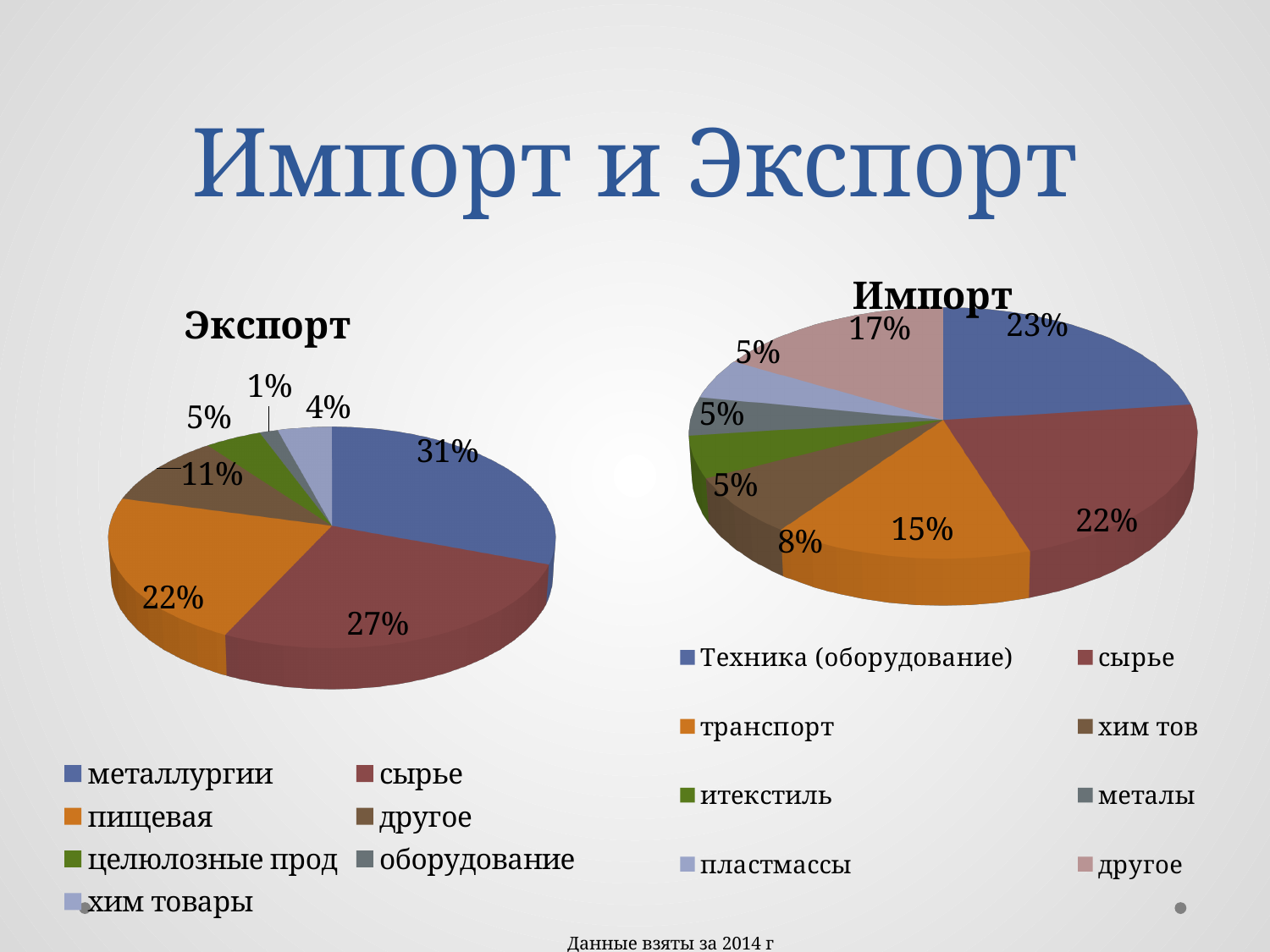
In the Экспорт chart, what share does металлургии have? 31% In the Экспорт chart, what share does пищевая have? 22% How many categories does the legend of the Импорт chart list? 8 In the Импорт chart, what share does другое have? 17% In the Экспорт chart, which category has the largest share? металлургии What type of chart is the Импорт chart? pie chart In the Импорт chart, which is larger: транспорт or хим тов? транспорт How many categories does the legend of the Экспорт chart list? 7 In the Импорт chart, what share does Техника (оборудование) have? 23% In the Экспорт chart, what is the difference between the shares of металлургии and сырье? 4% In the Экспорт chart, which category has the smallest share? оборудование In the Импорт chart, which category has the largest share? Техника (оборудование)